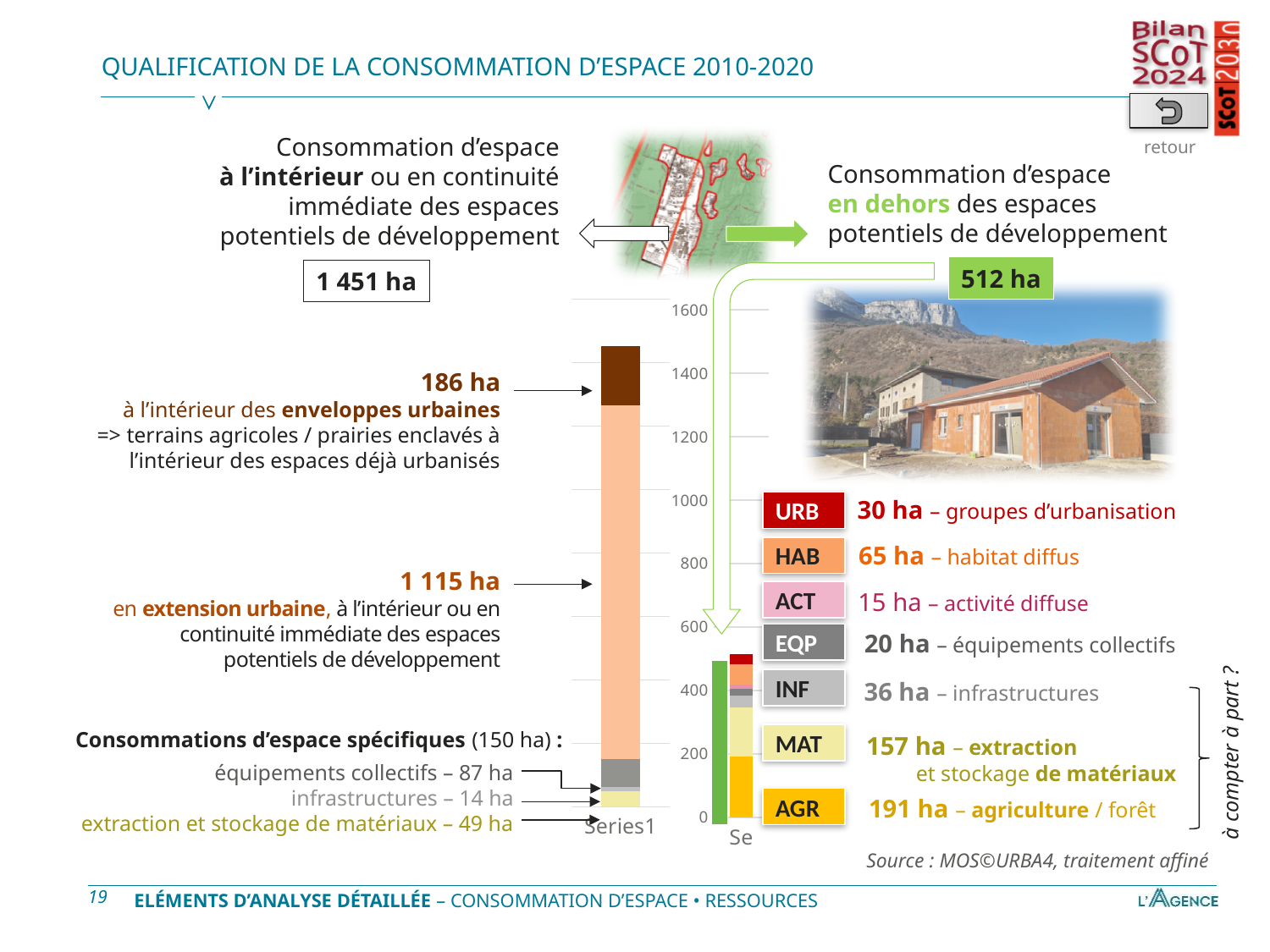
Which category of the right bar (outside the potential development areas) has the largest value? AGR Is the total of the right bar greater or less than 600? less How many hectares were consumed in 'extension urbaine'? 1 115 ha Which category of the right bar (outside the potential development areas) has the smallest value? ACT What is the total consumption of space inside or in immediate continuity of the potential development areas (left bar)? 1 451 ha How many hectares were consumed inside the 'enveloppes urbaines'? 186 ha What is the difference between the HAB (habitat diffus) and URB (groupes d'urbanisation) values? 35 ha How many hectares does the MAT (extraction et stockage de matériaux) category represent in the right bar? 157 ha What is the total consumption of space outside the potential development areas (right bar)? 512 ha What kind of chart is shown on the slide? bar chart Which is larger: the total of the left bar (Series1) or the total of the right bar? the left bar (1 451 ha) How many hectares does the AGR (agriculture / forêt) category represent? 191 ha